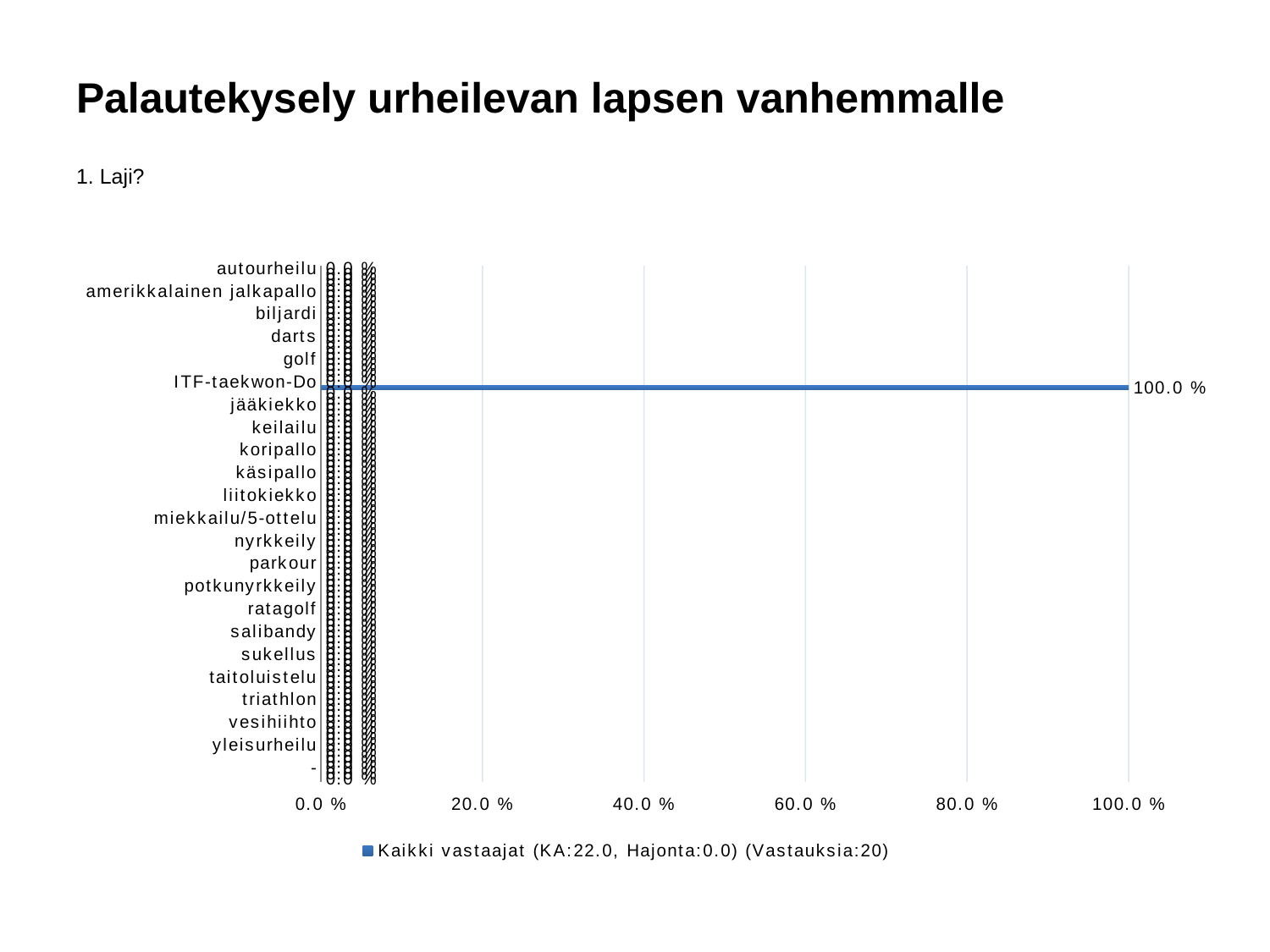
Is the value for golf greater or less than 20.0 %? less How many categories are listed on the vertical axis of the chart? 23 What kind of chart is shown on the slide? bar chart What survey question is the chart about? 1. Laji? What is the legend entry of the chart? Kaikki vastaajat (KA:22.0, Hajonta:0.0) (Vastauksia:20) How many series does the legend list? 1 Is the value for salibandy greater or less than 20.0 %? less